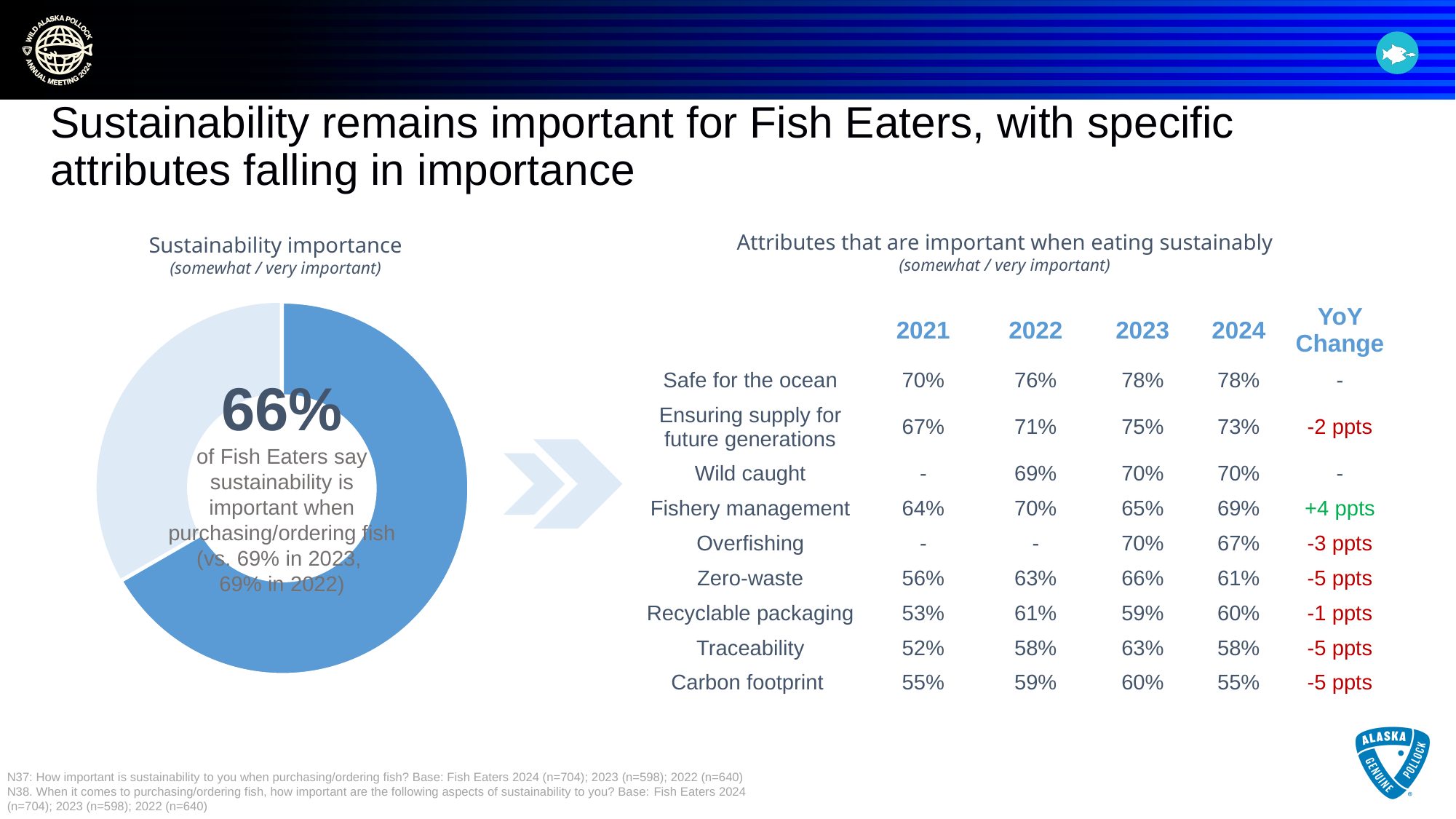
What is the title of the donut chart on the left of the slide? Sustainability importance How many slices does the Sustainability importance donut chart have? 2 In the Sustainability importance chart, is the dark blue slice larger or smaller than the light blue slice? Larger In the Attributes that are important when eating sustainably table, which attribute has the lowest value for 2024? Carbon footprint In the Attributes that are important when eating sustainably table, which attribute has the highest value for 2024? Safe for the ocean In the Sustainability importance chart, what percentage of Fish Eaters say sustainability is important when purchasing/ordering fish? 66% In the Attributes that are important when eating sustainably table, what is the YoY Change for Fishery management? +4 ppts In the Sustainability importance chart, what was the percentage of Fish Eaters saying sustainability is important in 2023? 69% In the Sustainability importance chart, is the highlighted value greater or less than 50%? greater In the Sustainability importance chart, what was the percentage of Fish Eaters saying sustainability is important in 2022? 69% What type of chart is used to show Sustainability importance on the left of the slide? Pie (donut) chart In the Sustainability importance chart, by how many percentage points did the share saying sustainability is important change from 2023 to 2024? 3 percentage points lower